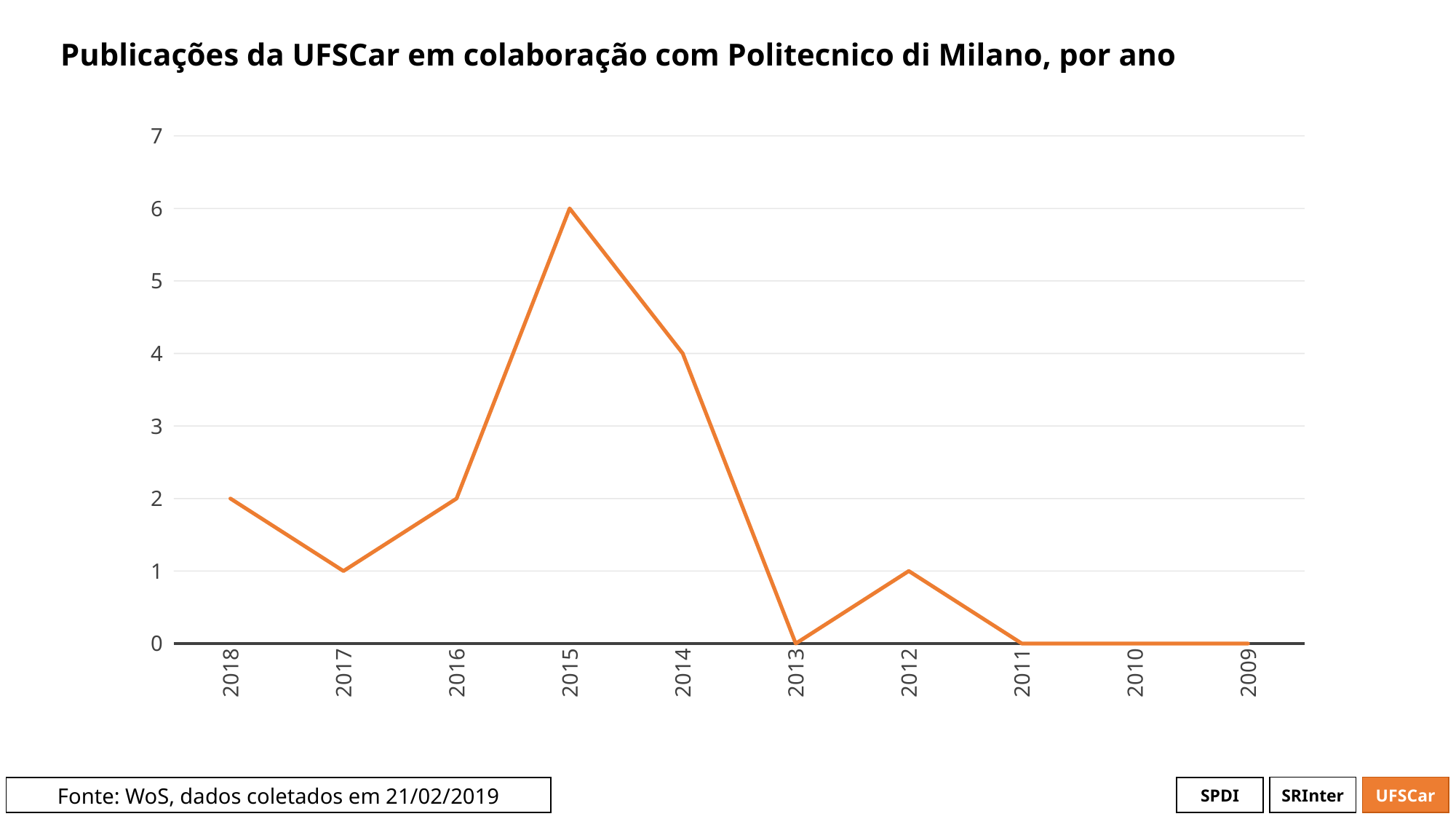
What type of chart is shown on the slide? line chart Which year has the highest value? 2015 What is the value for 2018? 2 What is the title of the chart? Publicações da UFSCar em colaboração com Politecnico di Milano, por ano What is the difference between the values for 2015 and 2014? 2 What is the value for 2014? 4 How many years are shown on the x axis? 10 Which is larger, the value for 2016 or the value for 2017? 2016 How many years have a value of 0? 4 Is the value for 2015 greater or less than 5? greater What is the value for 2012? 1 What is the value for 2015? 6